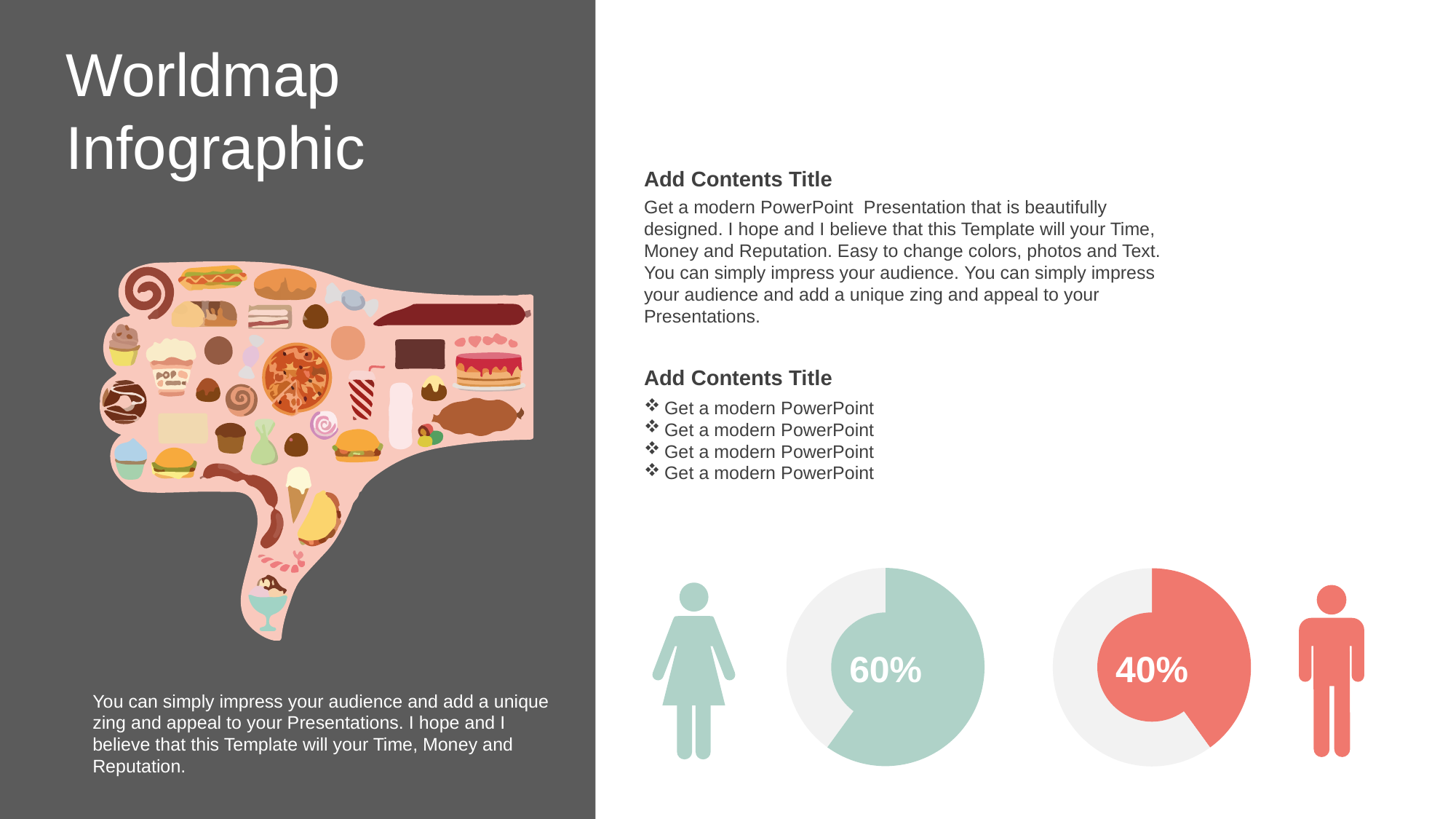
Which pie chart shows the larger percentage, the one next to the female figure or the one next to the male figure? The one next to the female figure What kind of chart is used to display the 60% and 40% values? Pie chart What percentage is shown in the pie chart next to the male figure? 40% What colour is the filled slice in the pie chart next to the male figure? Red What percentage is shown in the pie chart next to the female figure? 60% What is the total of the two percentages shown in the pie charts? 100% What colour is the filled slice in the pie chart next to the female figure? Green What is the difference between the percentage in the female pie chart and the percentage in the male pie chart? 20% Is the value in the pie chart next to the female figure greater or less than 50%? greater Is the value in the pie chart next to the male figure greater or less than 50%? less How many pie charts are shown on the slide? 2